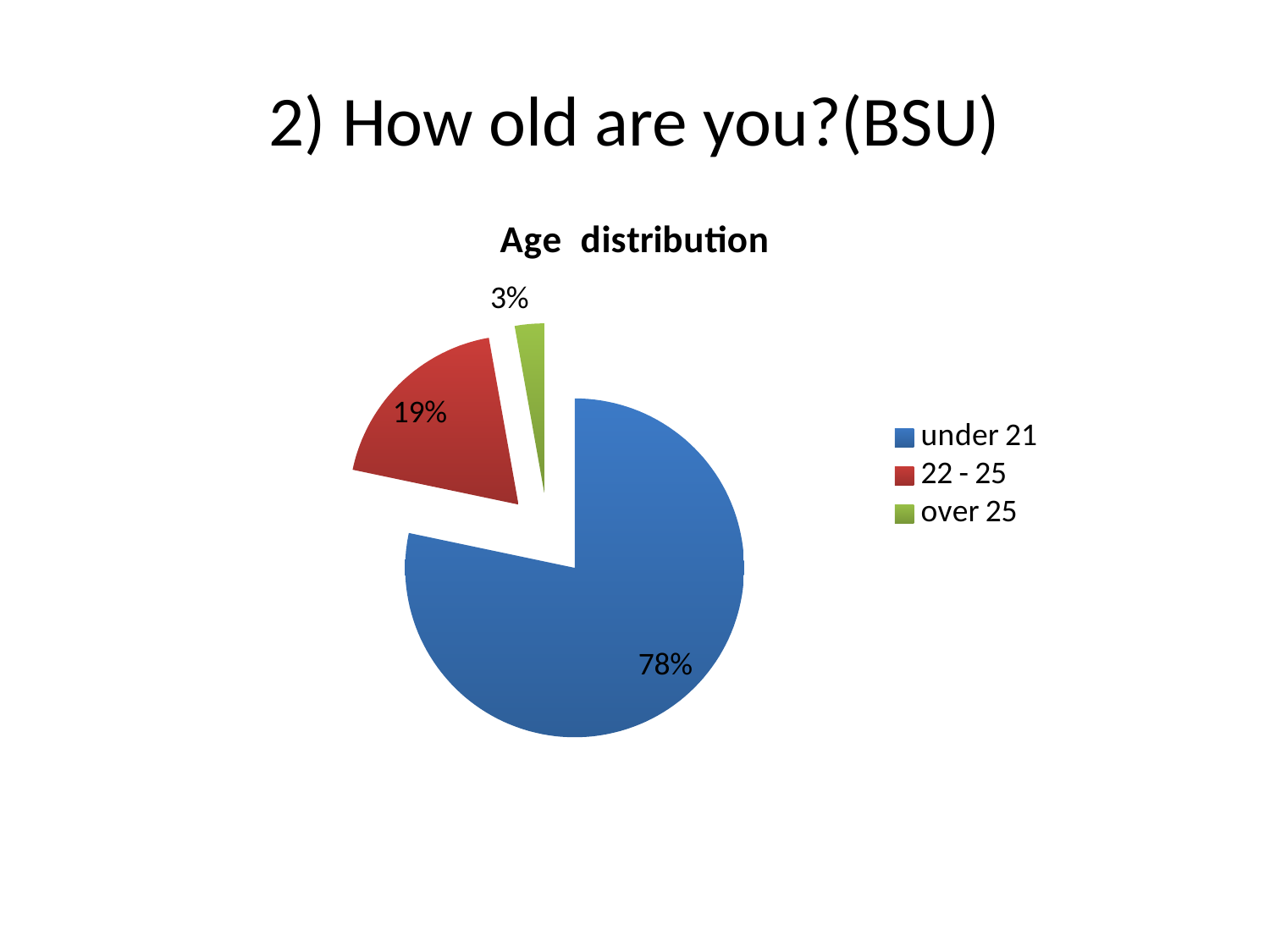
Which group is larger: 22 - 25 or over 25? 22 - 25 Which age group has the smallest share of the pie? over 25 Which age group has the largest share of the pie? under 21 What percentage of respondents are aged 22 - 25? 19% What is the difference in percentage points between the under 21 and 22 - 25 groups? 59 What is the title of the chart? Age distribution What colour represents the under 21 group? blue What percentage of respondents are over 25? 3% What type of chart is shown on the slide? pie chart How many age groups are shown in the pie chart? 3 What is the difference in percentage points between the 22 - 25 and over 25 groups? 16 What percentage of respondents are under 21? 78%